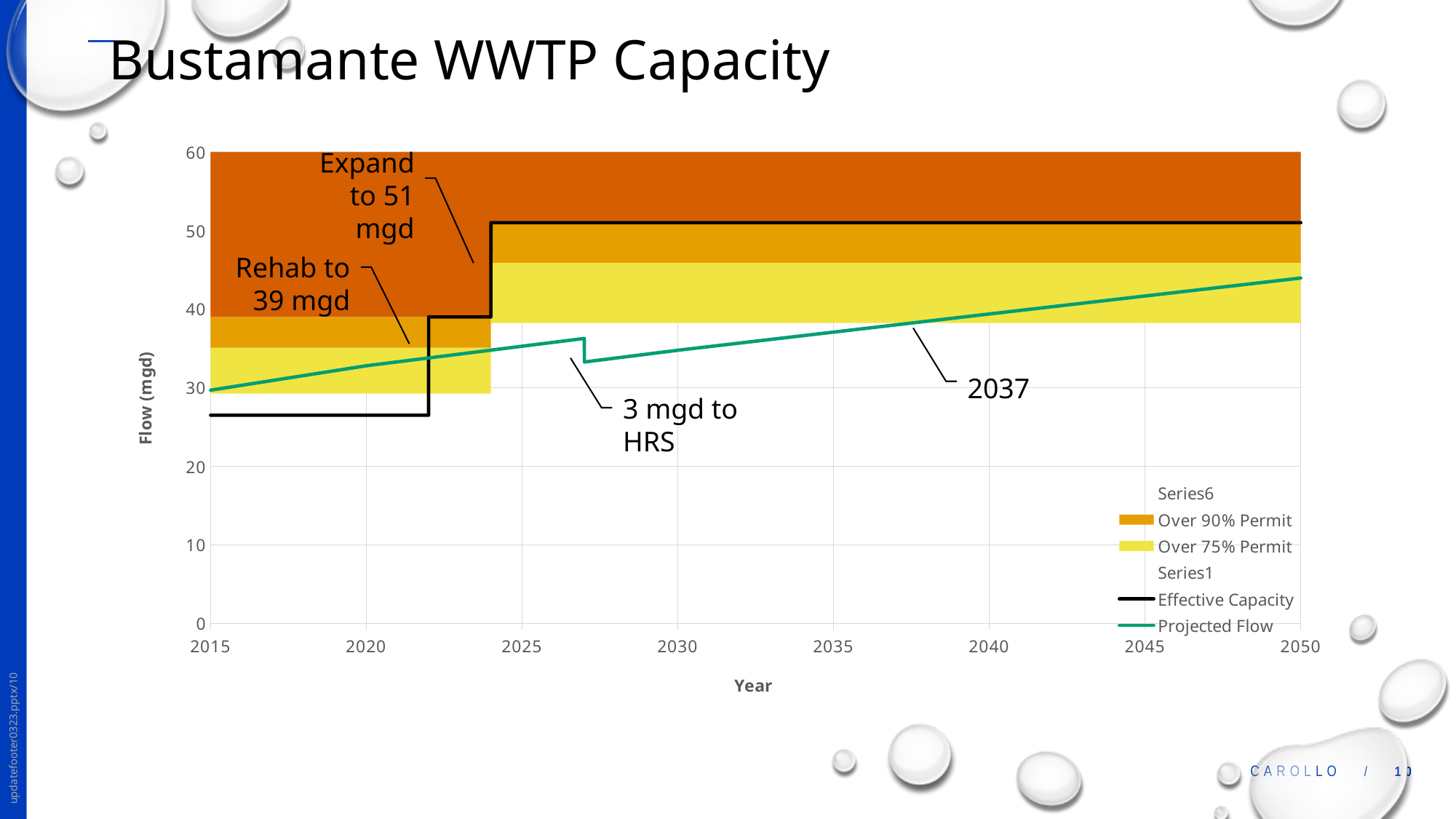
According to the annotation, what capacity does the rehab bring the plant to? 39 mgd How much flow is diverted to HRS according to the annotation? 3 mgd According to the annotation, what capacity does the plant expand to? 51 mgd Does the Projected Flow line generally rise or fall from 2015 to 2050? rise In 2050, which is higher, Effective Capacity or Projected Flow? Effective Capacity Is the Effective Capacity value in 2015 greater or less than 30? less What is the title of the vertical axis? Flow (mgd) How many series does the legend list? 6 Is the Projected Flow value in 2050 greater or less than 40? greater What kind of chart is shown on the slide? combination area and line chart What is the difference between the expanded capacity (51 mgd) and the rehab capacity (39 mgd)? 12 mgd What year is labelled where the Projected Flow line crosses into the Over 75% Permit band? 2037